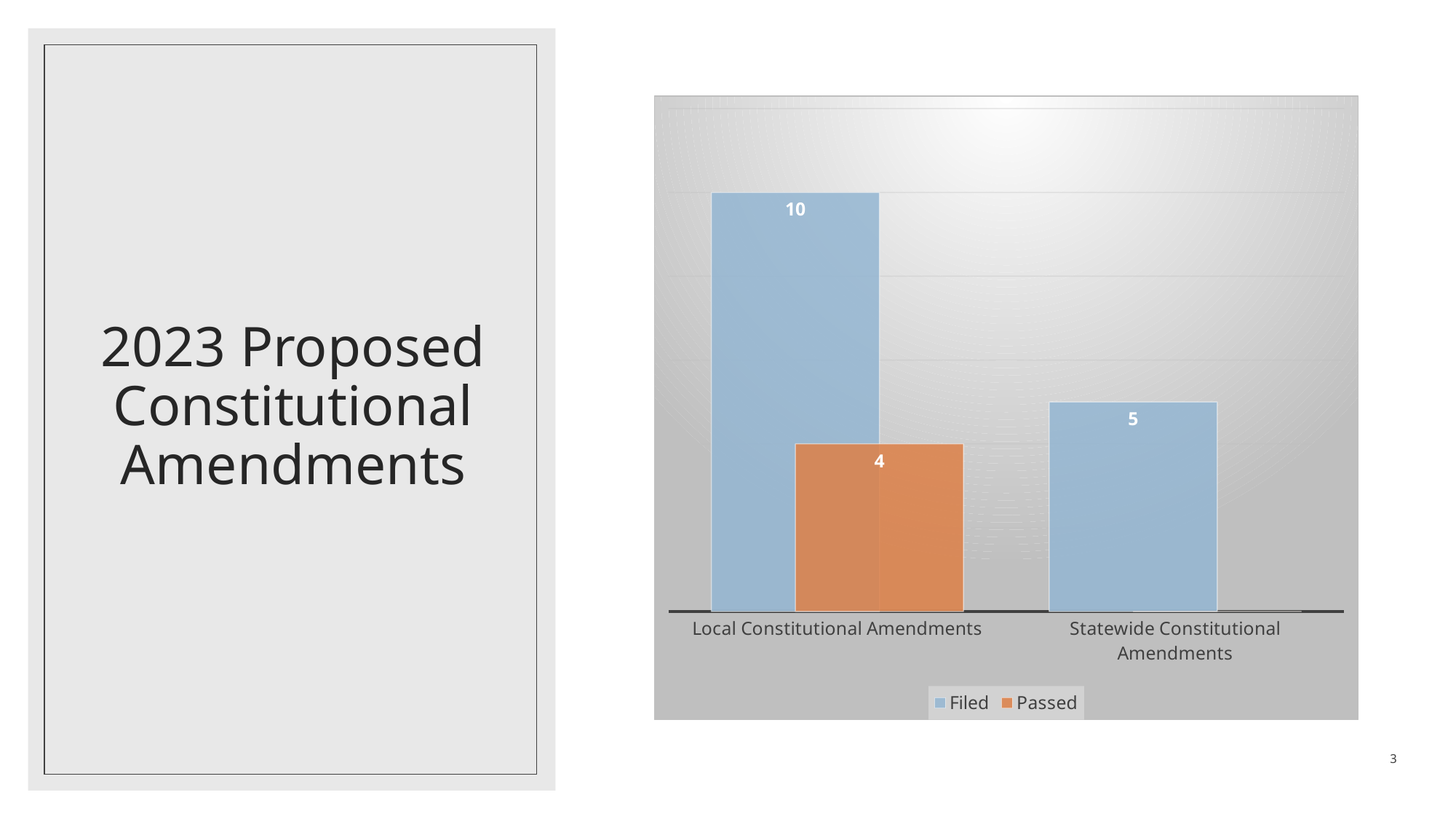
Which is larger: Filed Statewide Constitutional Amendments or Passed Local Constitutional Amendments? Filed Statewide Constitutional Amendments How many Local Constitutional Amendments were Filed? 10 What colour are the Passed bars? Orange How many categories are shown on the x axis? 2 How many series does the legend list? 2 How many Statewide Constitutional Amendments were Filed? 5 How many Local Constitutional Amendments were Passed? 4 Which category has the highest Filed value? Local Constitutional Amendments What is the difference between the number of Local Constitutional Amendments Filed and Passed? 6 What are the two series named in the legend? Filed and Passed What is the difference between Filed Local Constitutional Amendments and Filed Statewide Constitutional Amendments? 5 What kind of chart is shown on the slide? Bar chart